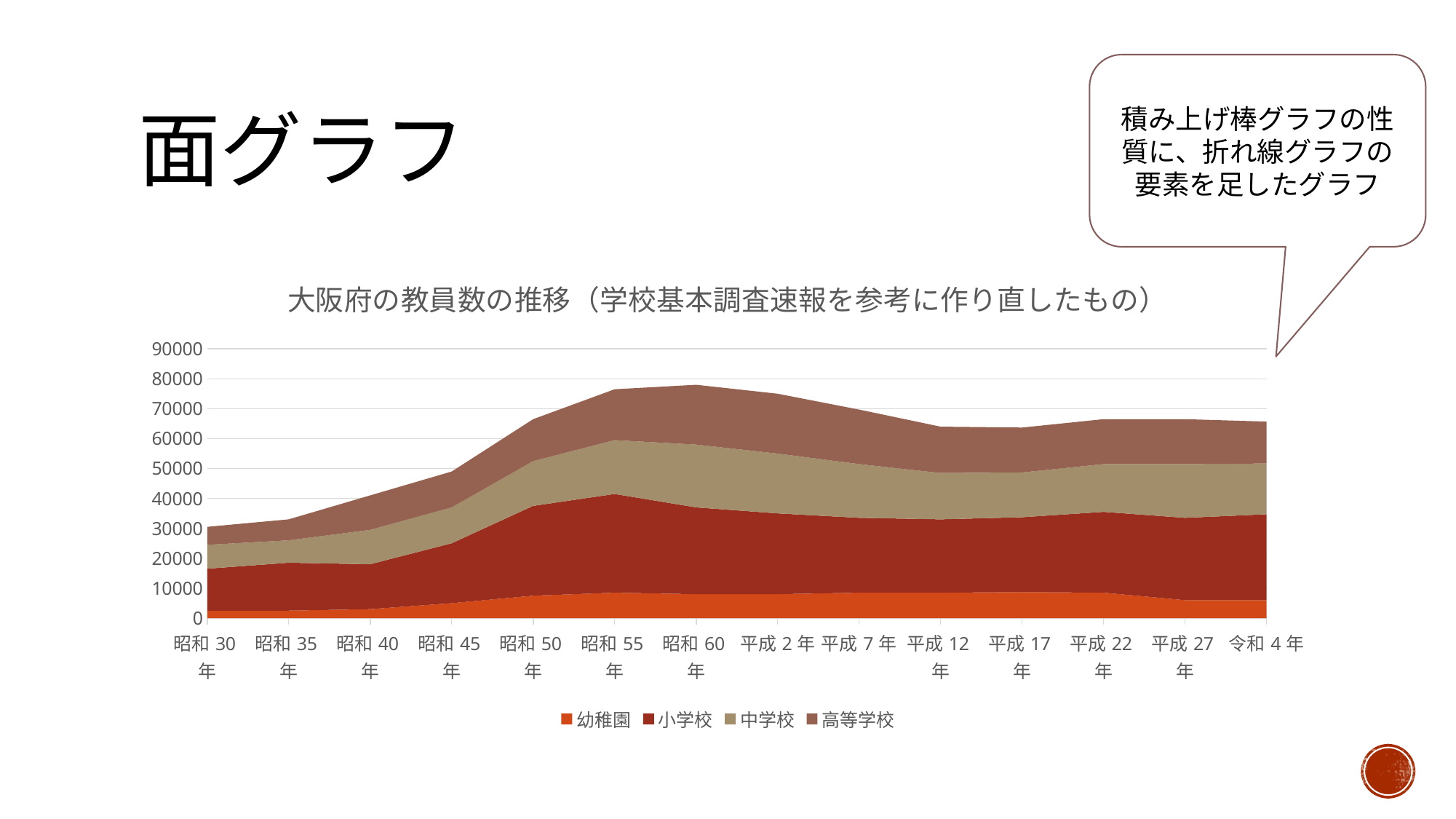
Which series is listed first in the legend? 幼稚園 What is the title of the chart? 大阪府の教員数の推移（学校基本調査速報を参考に作り直したもの） How many categories (years) are shown on the x axis? 14 In which year is the total number of teachers (top of the stacked area) the highest? 昭和 60 年 What kind of chart is shown on the slide? Area chart (stacked area chart) Which year has a larger total: 昭和 50 年 or 平成 2 年? 平成 2 年 In which year is the total number of teachers (top of the stacked area) the lowest? 昭和 30 年 How many series does the legend list? 4 Does the total number of teachers rise or fall from 昭和 30 年 to 昭和 60 年? rise Is the total value for 令和 4 年 greater or less than 70000? less Is the total value for 昭和 60 年 greater or less than 70000? greater